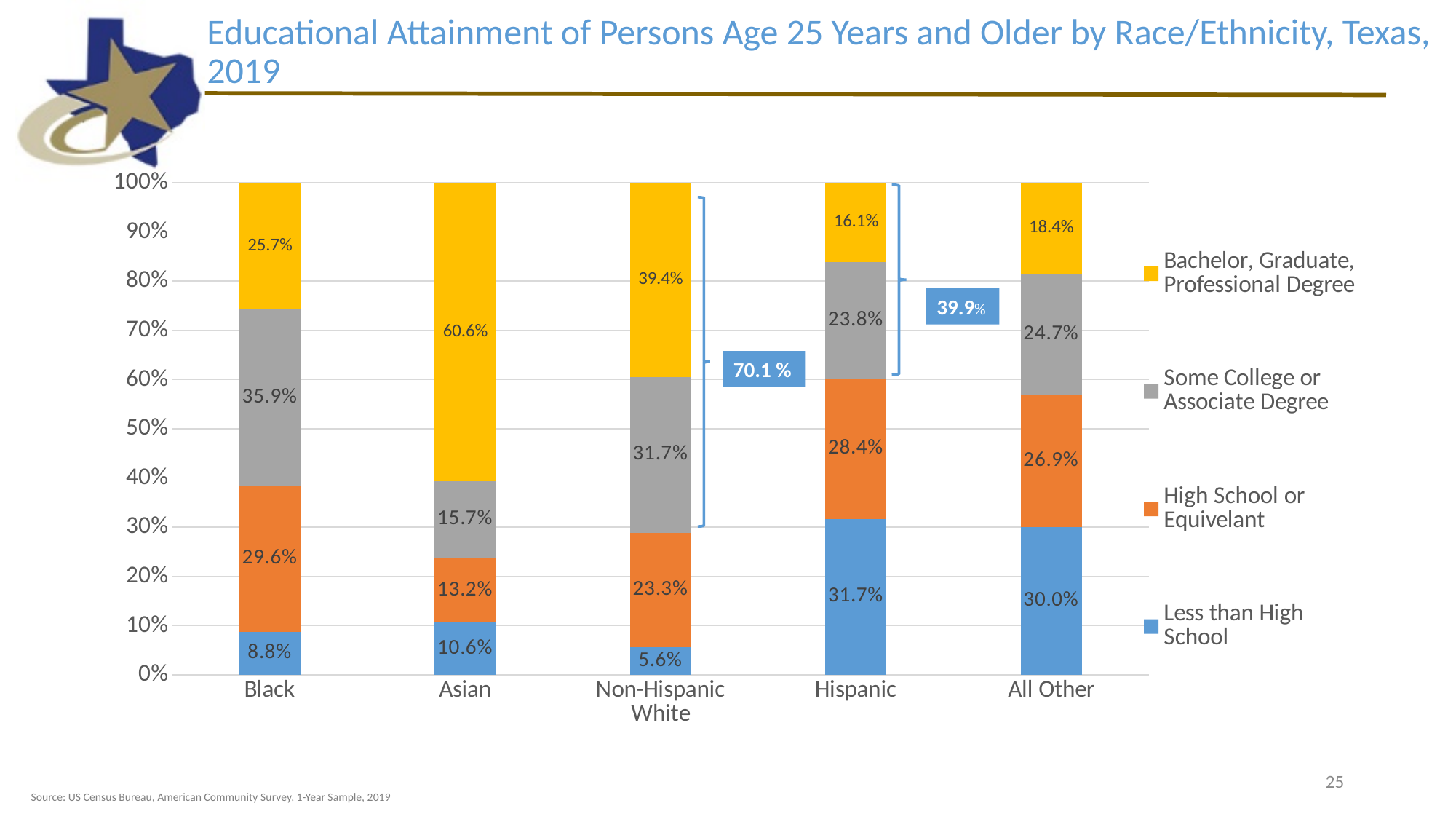
What is the combined share of Some College or Associate Degree and Bachelor, Graduate, Professional Degree for Hispanic persons? 39.9% What is the difference between the Bachelor, Graduate, Professional Degree shares for Asian and Hispanic persons? 44.5% How many series does the legend list? 4 Which legend entry is shown in yellow? Bachelor, Graduate, Professional Degree What percentage of Black persons age 25 and older have a Bachelor, Graduate, or Professional Degree? 25.7% What is the Less than High School share for Hispanic persons? 31.7% How many race/ethnicity categories are shown on the x axis? 5 What is the High School or Equivelant value for the Asian group? 13.2% Which race/ethnicity group has the highest share with a Bachelor, Graduate, or Professional Degree? Asian Which is larger: the Some College or Associate Degree share for Black persons or for Non-Hispanic White persons? Black Which group has the lowest Less than High School share? Non-Hispanic White What kind of chart is shown on the slide? Stacked bar chart